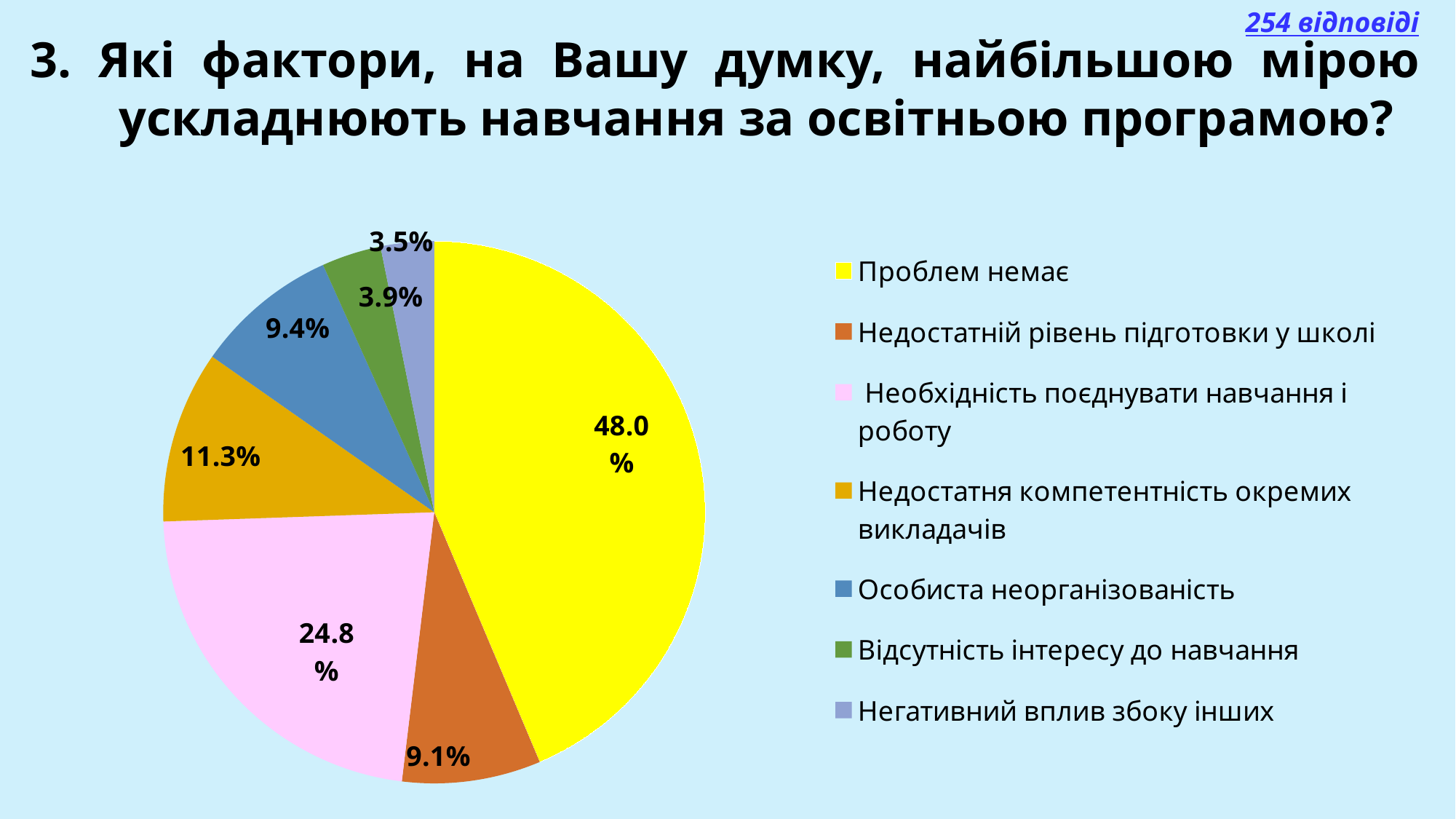
Which category has the largest slice of the pie? Проблем немає What is the difference between the shares for "Проблем немає" and "Необхідність поєднувати навчання і роботу"? 23.2% What colour is the slice for "Недостатній рівень підготовки у школі"? orange How many categories does the pie chart have? 7 What share of responses is "Особиста неорганізованість"? 9.4% Which is larger: the share for "Недостатня компетентність окремих викладачів" or for "Відсутність інтересу до навчання"? Недостатня компетентність окремих викладачів Which category has the smallest slice of the pie? Негативний вплив збоку інших What share of responses is "Необхідність поєднувати навчання і роботу"? 24.8% What share of responses is "Недостатня компетентність окремих викладачів"? 11.3% What kind of chart is shown on the slide? pie chart What share of responses is "Негативний вплив збоку інших"? 3.5% What share of responses is "Проблем немає"? 48.0%